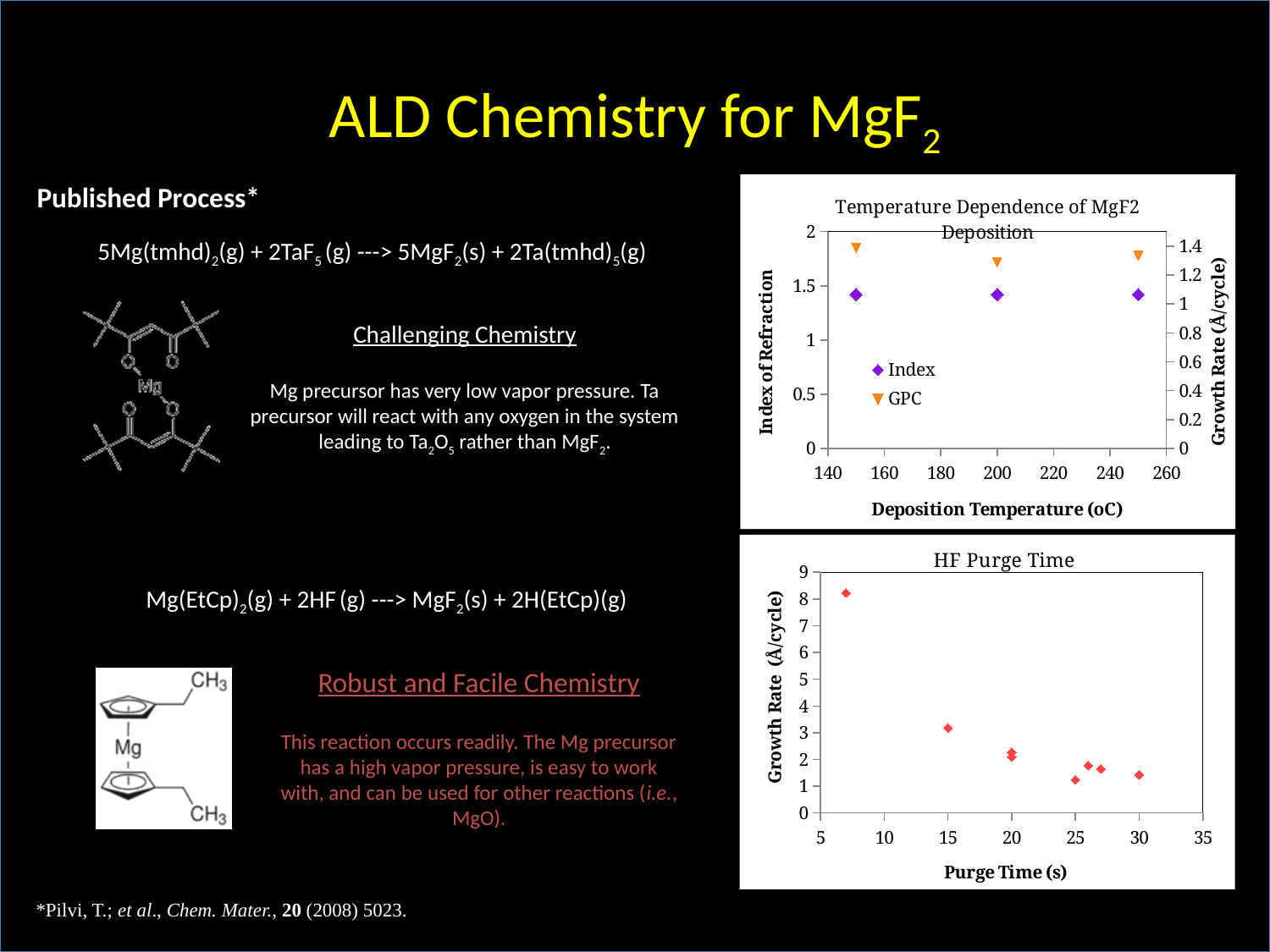
How many series does the legend of the 'Temperature Dependence of MgF2 Deposition' chart list? 2 In the 'HF Purge Time' chart, how many data points are plotted? 8 In the 'Temperature Dependence of MgF2 Deposition' chart, is the Index value at 200 °C greater or less than 1.5? less In the 'HF Purge Time' chart, does the growth rate rise or fall as purge time increases? fall What is the x-axis label of the 'HF Purge Time' chart? Purge Time (s) In the 'Temperature Dependence of MgF2 Deposition' chart, is the GPC value at 150 °C greater or less than 1 Å/cycle on the right axis? greater In the 'Temperature Dependence of MgF2 Deposition' chart, what are the two legend entries? Index and GPC What kind of chart is the 'HF Purge Time' chart? scatter chart In the 'Temperature Dependence of MgF2 Deposition' chart, how many data points are plotted for the Index series? 3 In the 'Temperature Dependence of MgF2 Deposition' chart, is the Index value at 150 °C greater or less than 1? greater